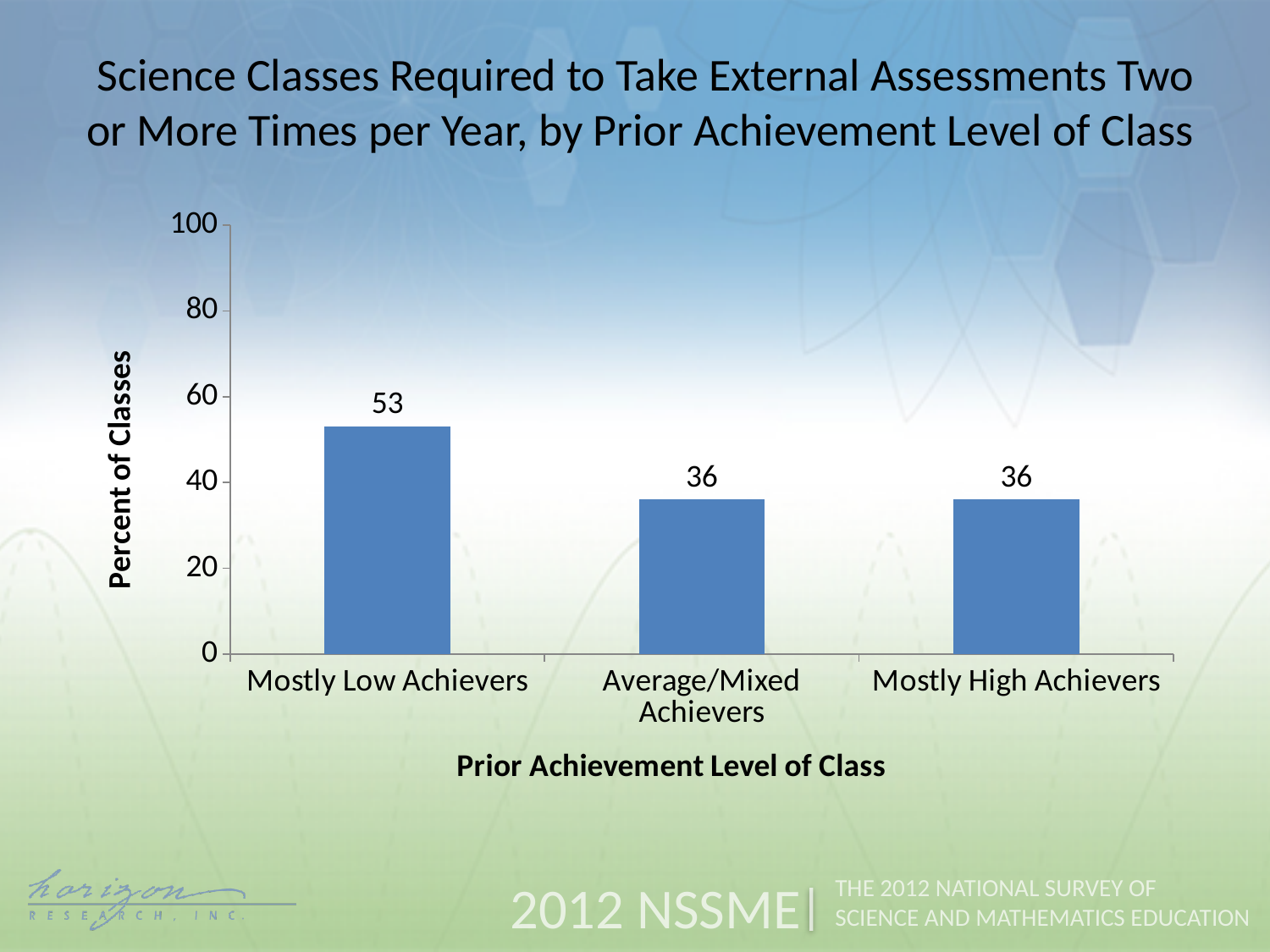
What kind of chart is shown on the slide? Bar chart Which is larger, the value for Mostly Low Achievers or the value for Average/Mixed Achievers? Mostly Low Achievers What is the label of the y axis? Percent of Classes What is the label of the x axis? Prior Achievement Level of Class What is the difference between the values for Mostly Low Achievers and Mostly High Achievers? 17 Which prior achievement level has the highest percent of classes? Mostly Low Achievers How many categories are shown on the x axis? 3 Is the value for Average/Mixed Achievers greater or less than 40? less Is the value for Mostly Low Achievers greater or less than 40? greater What is the value for Mostly High Achievers? 36 What is the value for Mostly Low Achievers? 53 What is the value for Average/Mixed Achievers? 36